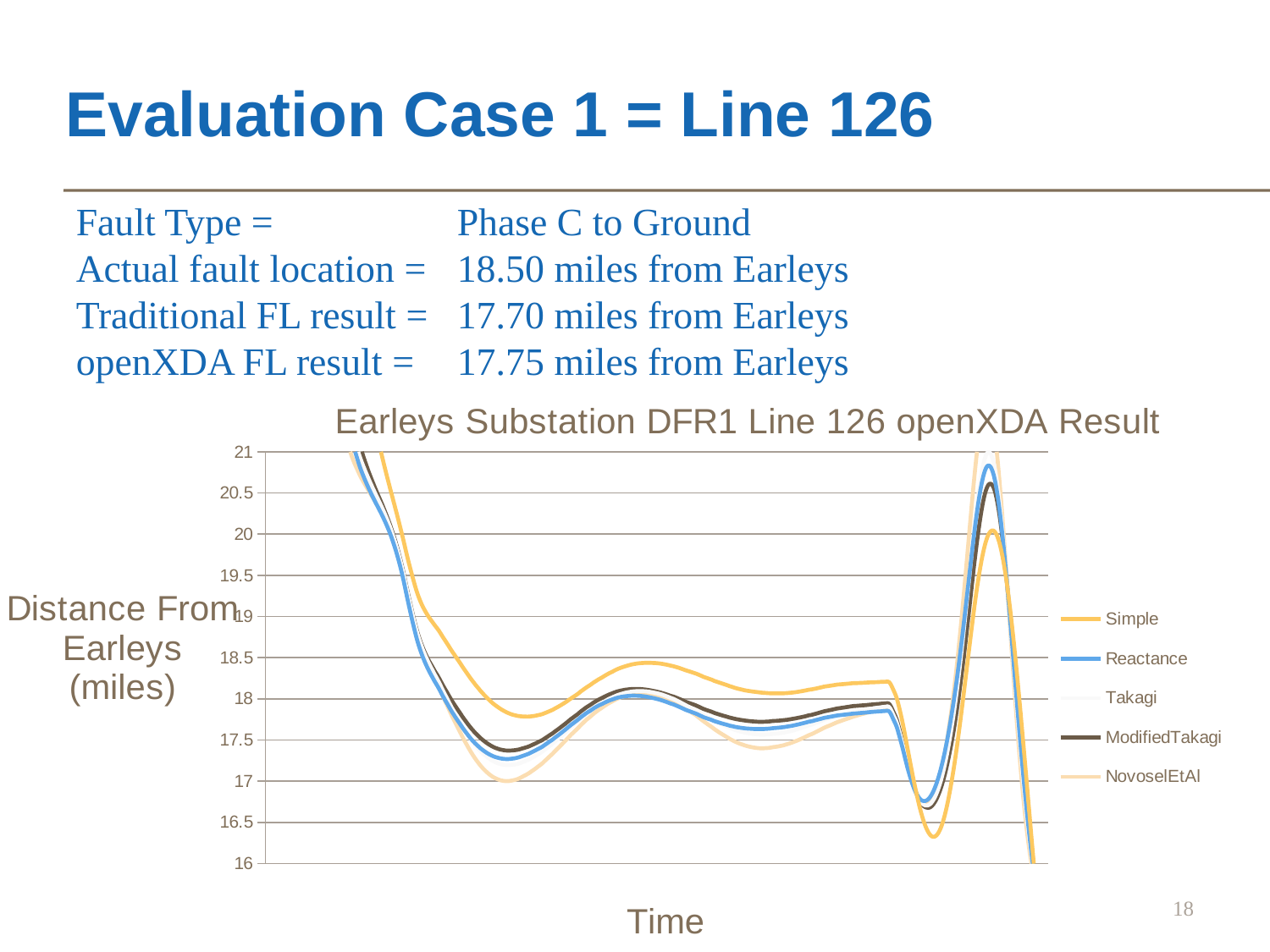
Which series reaches the lowest value in the dip near the right side of the chart? Simple Is the lowest value of the Simple line in the dip near the right side greater or less than 16.5? less What is the title of the chart? Earleys Substation DFR1 Line 126 openXDA Result In the first dip of the chart, is the Simple line higher or lower than the Reactance line? Higher Which series in the chart is drawn in blue? Reactance In the middle plateau region of the chart, which series has the highest values? Simple What is the label of the x axis of the chart? Time What kind of chart is shown on the slide? Line chart At the left edge of the chart, do the lines rise or fall as time increases? Fall Is the lowest value of the Simple line in its first dip greater or less than 17.5? greater Is the peak value of the ModifiedTakagi line near the right side greater or less than 20? greater How many series does the legend of the chart list? 5